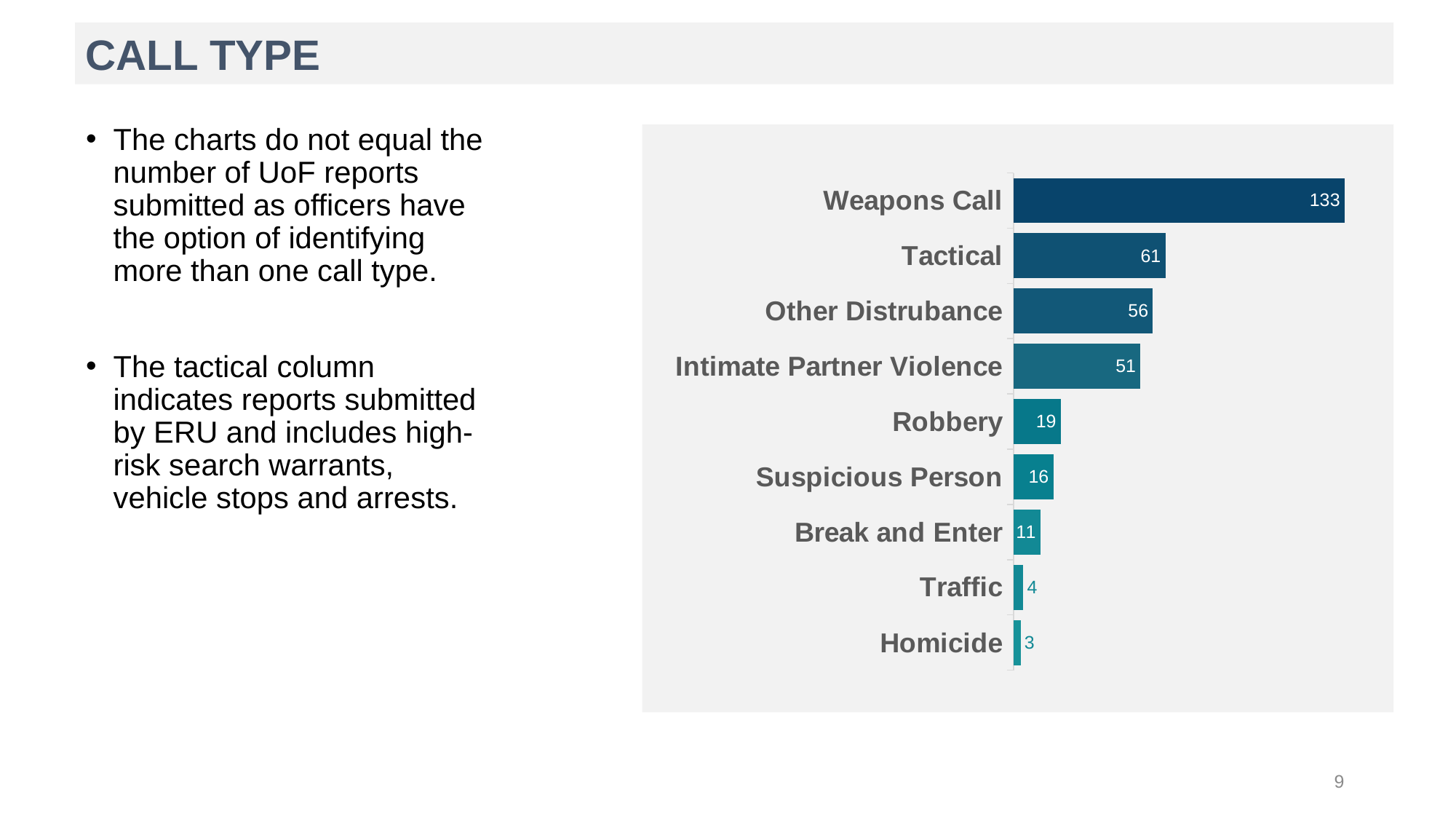
Which call type has the highest value? Weapons Call What is the difference between the values for Robbery and Suspicious Person? 3 Which call type has the lowest value? Homicide What is the difference between the values for Weapons Call and Tactical? 72 Which is larger, the value for Tactical or the value for Other Distrubance? Tactical What is the value for Break and Enter? 11 Are the bars in the chart arranged horizontally or vertically? Horizontally What is the value for Intimate Partner Violence? 51 What is the value for Traffic? 4 How many call type categories are shown in the chart? 9 What is the value for Weapons Call? 133 What kind of chart is shown on the slide? Bar chart